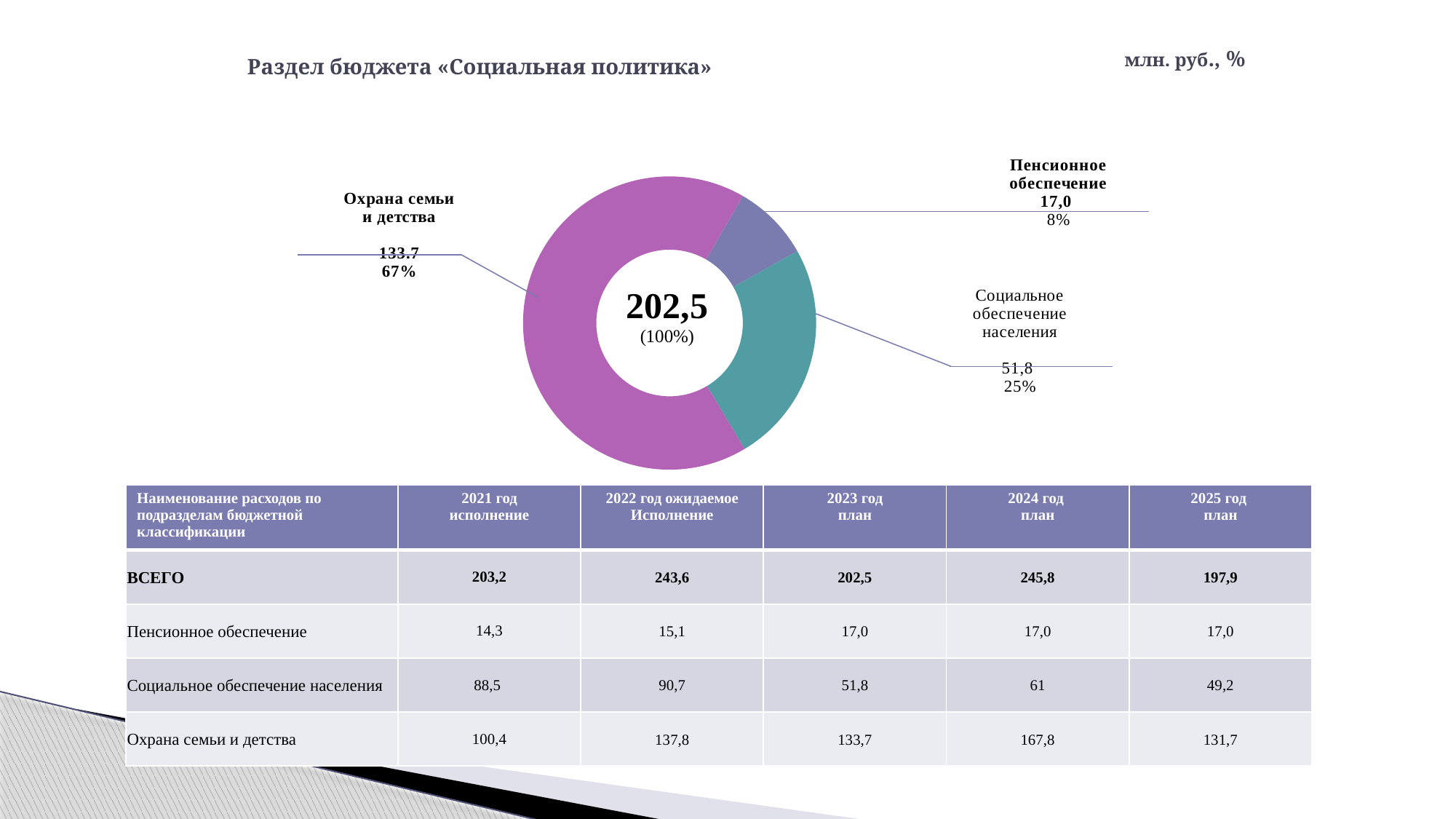
What share of the donut chart does Охрана семьи и детства represent? 67% What total value is shown in the centre of the donut chart? 202,5 What share of the donut chart does Социальное обеспечение населения represent? 25% What is the value shown for Охрана семьи и детства on the donut chart? 133,7 What is the value shown for Пенсионное обеспечение on the donut chart? 17,0 What share of the donut chart does Пенсионное обеспечение represent? 8% What kind of chart is shown on the slide? Donut (pie) chart Which slice of the donut chart is the smallest? Пенсионное обеспечение What is the difference between the values for Социальное обеспечение населения and Пенсионное обеспечение on the donut chart? 34,8 Which slice of the donut chart is the largest? Охрана семьи и детства What is the value shown for Социальное обеспечение населения on the donut chart? 51,8 How many slices does the donut chart have? 3